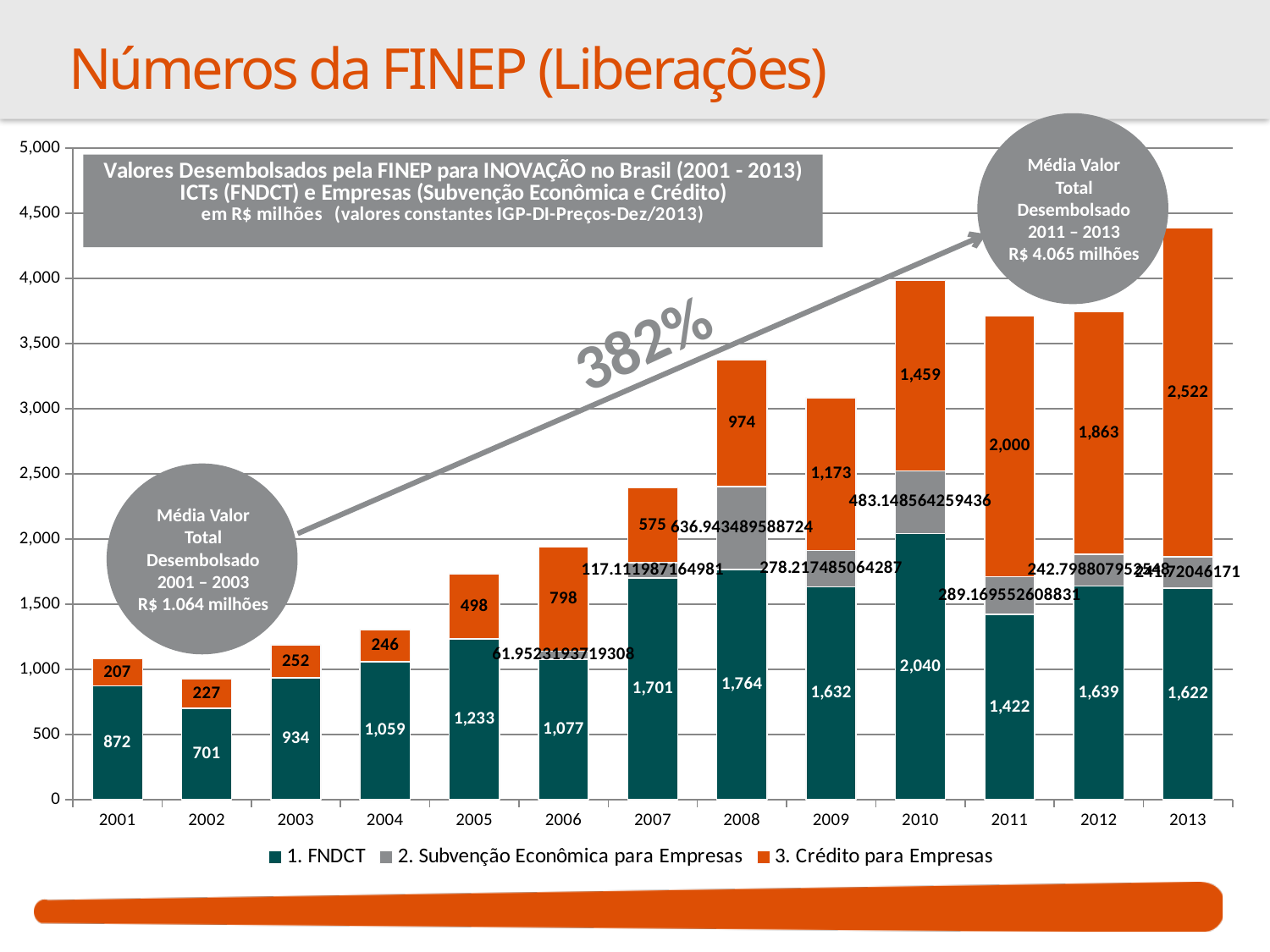
What is the value of 3. Crédito para Empresas in 2013? 2,522 What is the difference between the 3. Crédito para Empresas values for 2013 and 2011? 522 Does the 3. Crédito para Empresas value generally rise or fall from 2001 to 2013? Rise In which year is the 1. FNDCT value highest? 2010 What is the total stacked value for 2001? 1,079 How many years are shown on the x axis? 13 What is the value of 1. FNDCT in 2010? 2,040 How many series does the legend list? 3 Is the total stacked value for 2013 greater or less than 4,000? greater Which year has the larger 1. FNDCT value, 2007 or 2008? 2008 What kind of chart is shown on the slide? Stacked bar chart In which year is the 1. FNDCT value lowest? 2002